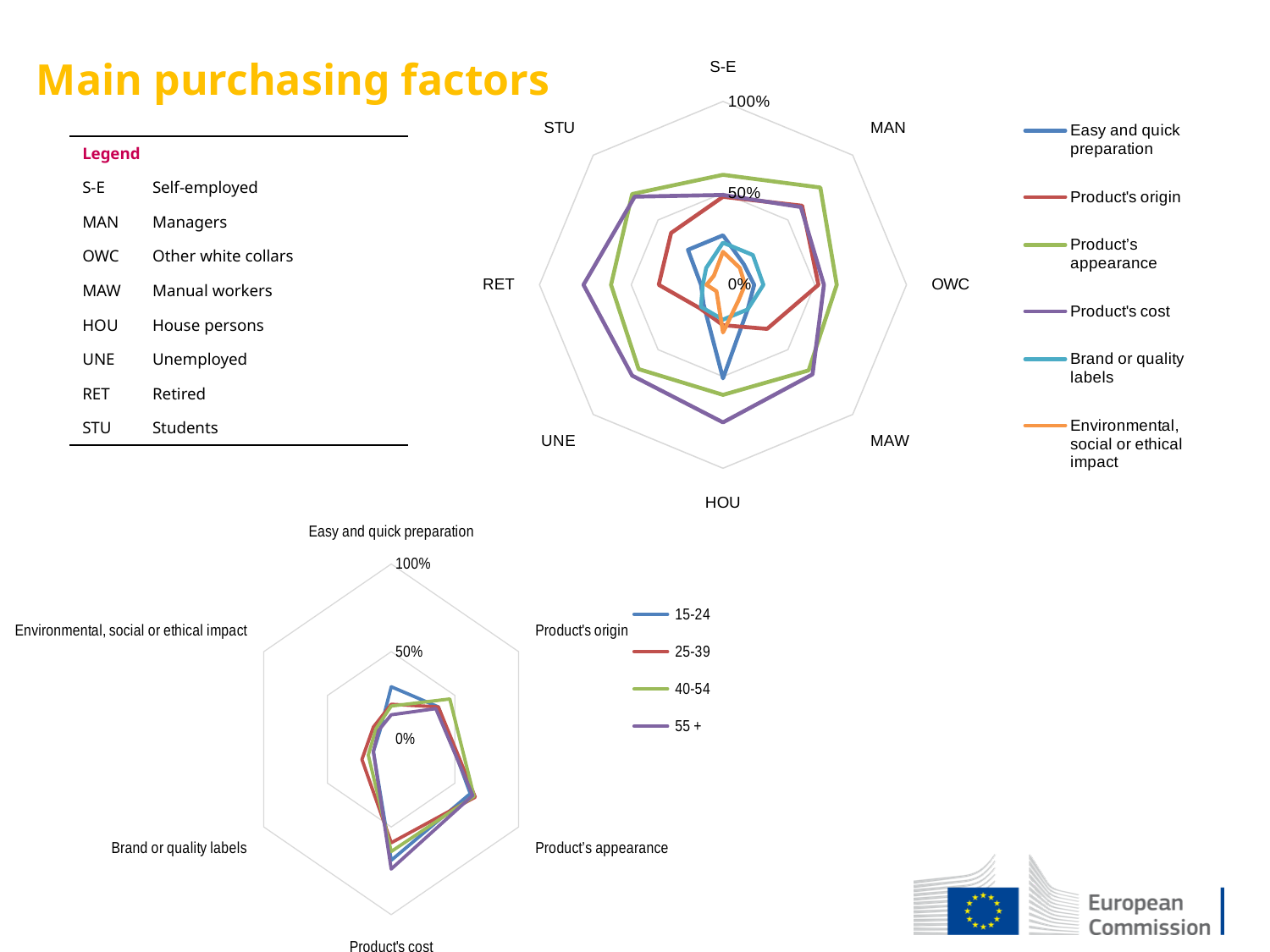
In the bottom radar chart, which is larger for the 55 + group: Product's cost or Environmental, social or ethical impact? Product's cost In the top radar chart, is the value of Easy and quick preparation for S-E greater or less than 50%? less How many series does the legend of the bottom radar chart list? 4 In the top radar chart, which is larger for RET: Product's cost or Easy and quick preparation? Product's cost In the top radar chart, is the value of Product's appearance for MAN greater or less than 50%? greater In the bottom radar chart, is the value of Product's cost for the 55 + group greater or less than 50%? greater What type of chart is the top chart on the slide? Radar chart How many series does the legend of the top radar chart list? 6 How many purchasing factors are plotted around the bottom radar chart? 6 How many occupation categories are plotted around the top radar chart? 8 What is the title of the slide containing the two radar charts? Main purchasing factors